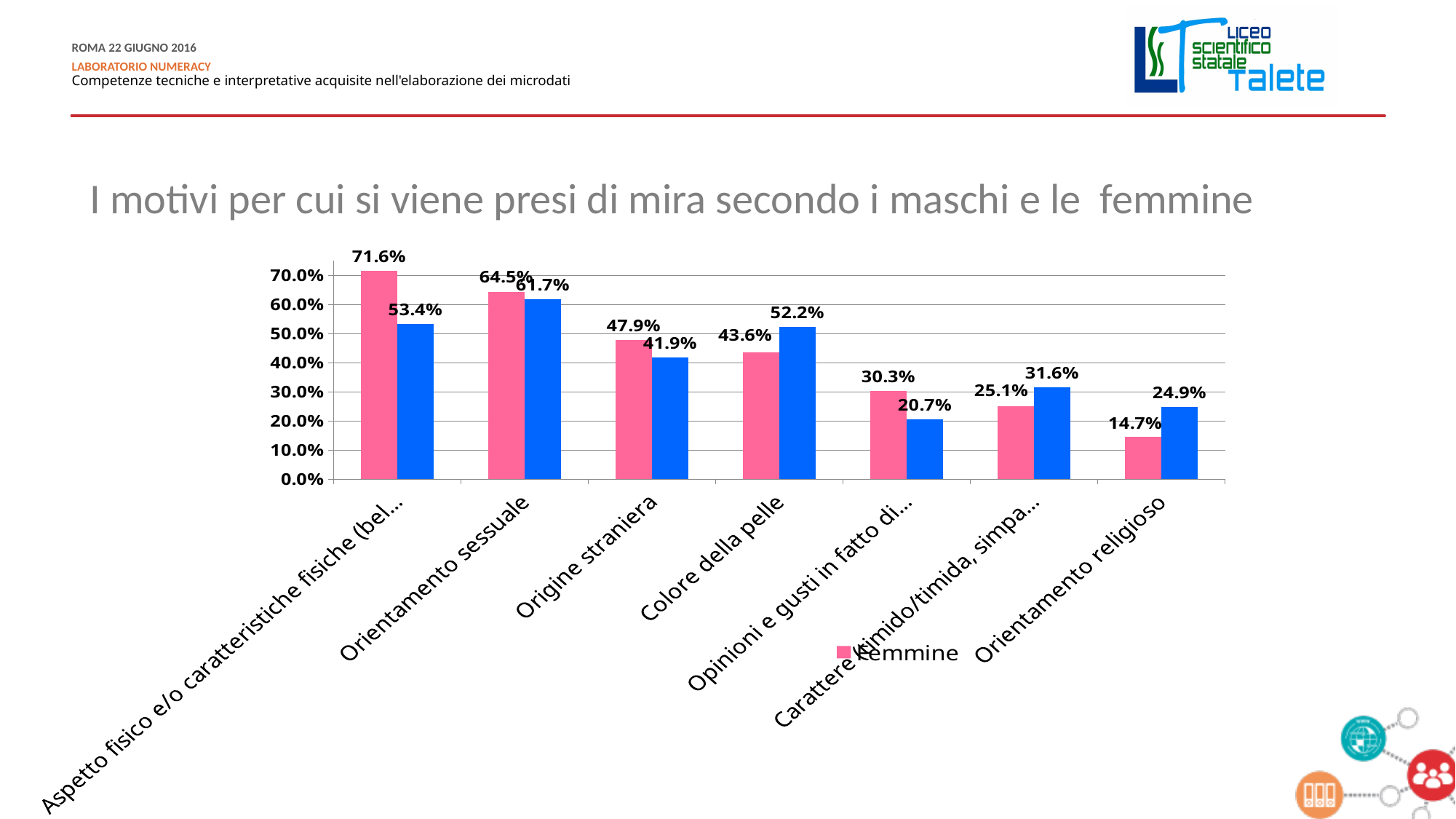
Which category has the lowest value among the blue bars? Opinioni e gusti in fatto di... How many categories are shown on the x axis? 7 What is the femmine value for Orientamento sessuale? 64.5% What is the difference between the femmine value and the blue bar value for Aspetto fisico e/o caratteristiche fisiche? 18.2% Is the femmine value for Origine straniera greater or less than 40.0%? greater What is the value of the blue bar for Origine straniera? 41.9% What colour are the femmine bars? pink What is the value of the blue bar for Colore della pelle? 52.2% For Colore della pelle, which is larger: the femmine bar or the blue bar? the blue bar Which category has the highest femmine value? Aspetto fisico e/o caratteristiche fisiche What is the femmine value for Orientamento religioso? 14.7% What kind of chart is shown on the slide? bar chart